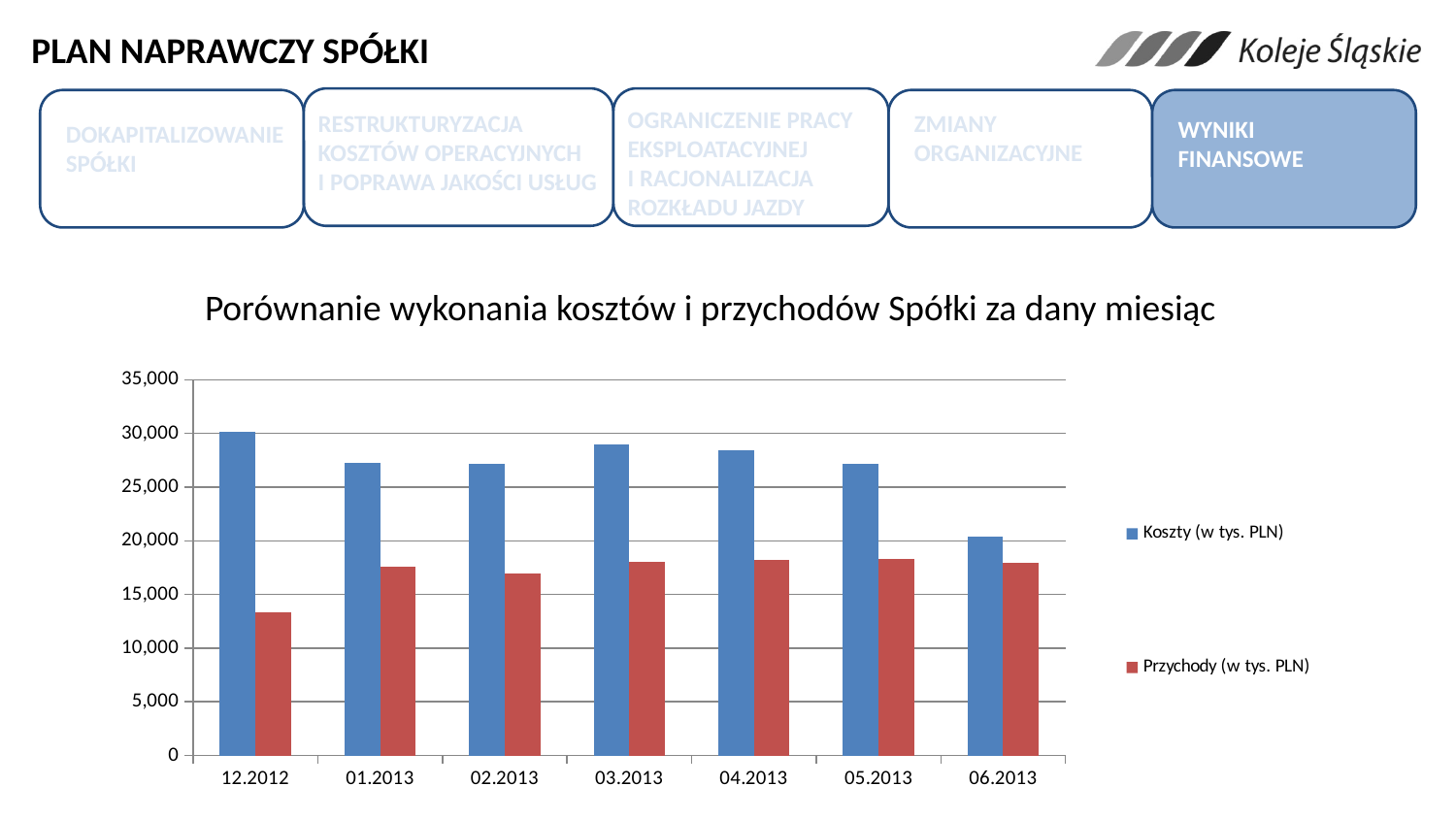
How many series does the legend list? 2 Which month has the lowest value for Przychody (w tys. PLN)? 12.2012 In 12.2012, which is larger: Koszty (w tys. PLN) or Przychody (w tys. PLN)? Koszty (w tys. PLN) How many months are shown on the x axis? 7 Is Koszty (w tys. PLN) higher in 12.2012 or in 06.2013? 12.2012 What kind of chart is shown on the slide? bar chart Is the value for Koszty (w tys. PLN) in 03.2013 greater or less than 25,000? greater Is the value for Koszty (w tys. PLN) in 06.2013 greater or less than 25,000? less What is the title of the chart? Porównanie wykonania kosztów i przychodów Spółki za dany miesiąc Which month has the highest value for Koszty (w tys. PLN)? 12.2012 Which month has the lowest value for Koszty (w tys. PLN)? 06.2013 Is the value for Przychody (w tys. PLN) in 12.2012 greater or less than 15,000? less